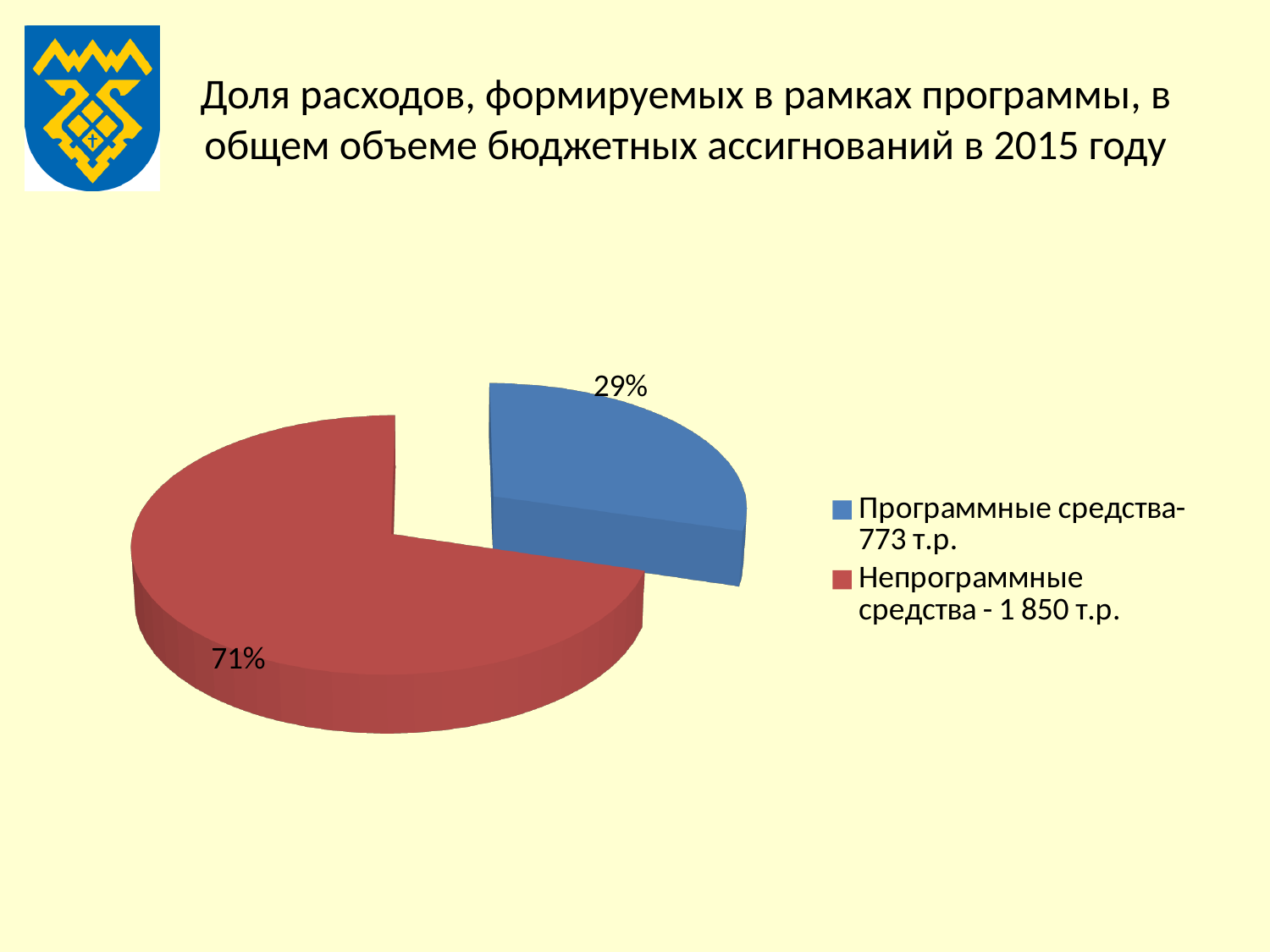
What share of the pie does "Непрограммные средства" represent? 71% What is the difference in percentage points between the "Непрограммные средства" slice and the "Программные средства" slice? 42 How many slices does the pie chart have? 2 What kind of chart is shown on the slide? pie chart What amount in thousand rubles does the legend give for "Программные средства"? 773 т.р. Which slice of the pie is the largest? Непрограммные средства What colour is the "Непрограммные средства" slice? red What amount in thousand rubles does the legend give for "Непрограммные средства"? 1 850 т.р. How many entries does the legend list? 2 Which slice of the pie is the smallest? Программные средства Which is larger: the share for "Программные средства" or the share for "Непрограммные средства"? Непрограммные средства What share of the pie does "Программные средства" represent? 29%